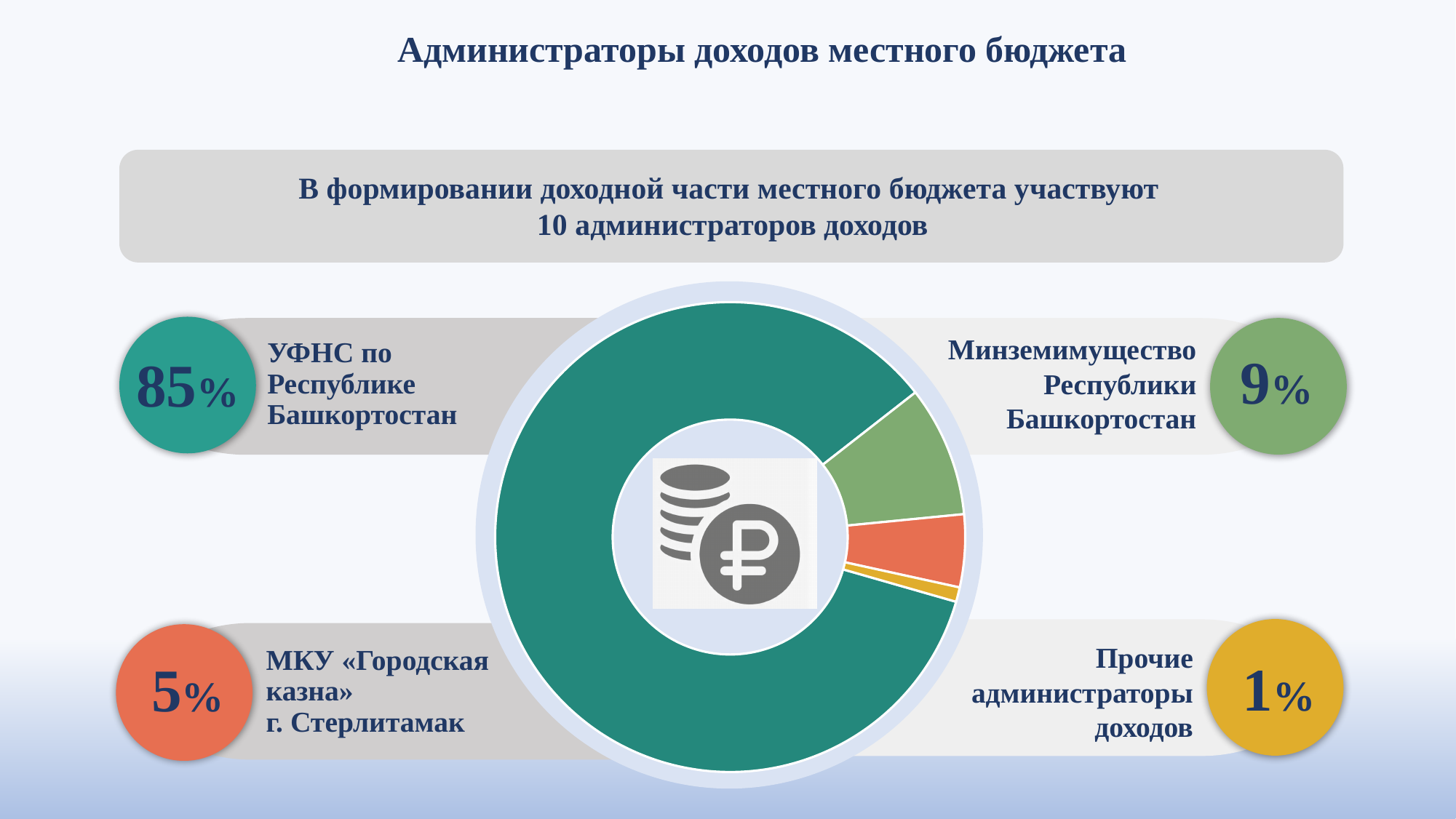
What kind of chart is shown on the slide? Pie chart (donut) What share is attributed to Прочие администраторы доходов? 1% What share of local budget revenue is administered by УФНС по Республике Башкортостан? 85% How many segments does the pie chart have? 4 Which revenue administrator has the largest share of the pie? УФНС по Республике Башкортостан Which is larger: the share of Минземимущество Республики Башкортостан or the share of МКУ «Городская казна» г. Стерлитамак? Минземимущество Республики Башкортостан Which category has the smallest share of the pie? Прочие администраторы доходов What share is attributed to МКУ «Городская казна» г. Стерлитамак? 5% What is the difference between the shares of УФНС по Республике Башкортостан and Минземимущество Республики Башкортостан? 76% What colour is the segment representing МКУ «Городская казна» г. Стерлитамак? Orange-red What share is attributed to Минземимущество Республики Башкортостан? 9% What is the title of the slide containing the chart? Администраторы доходов местного бюджета